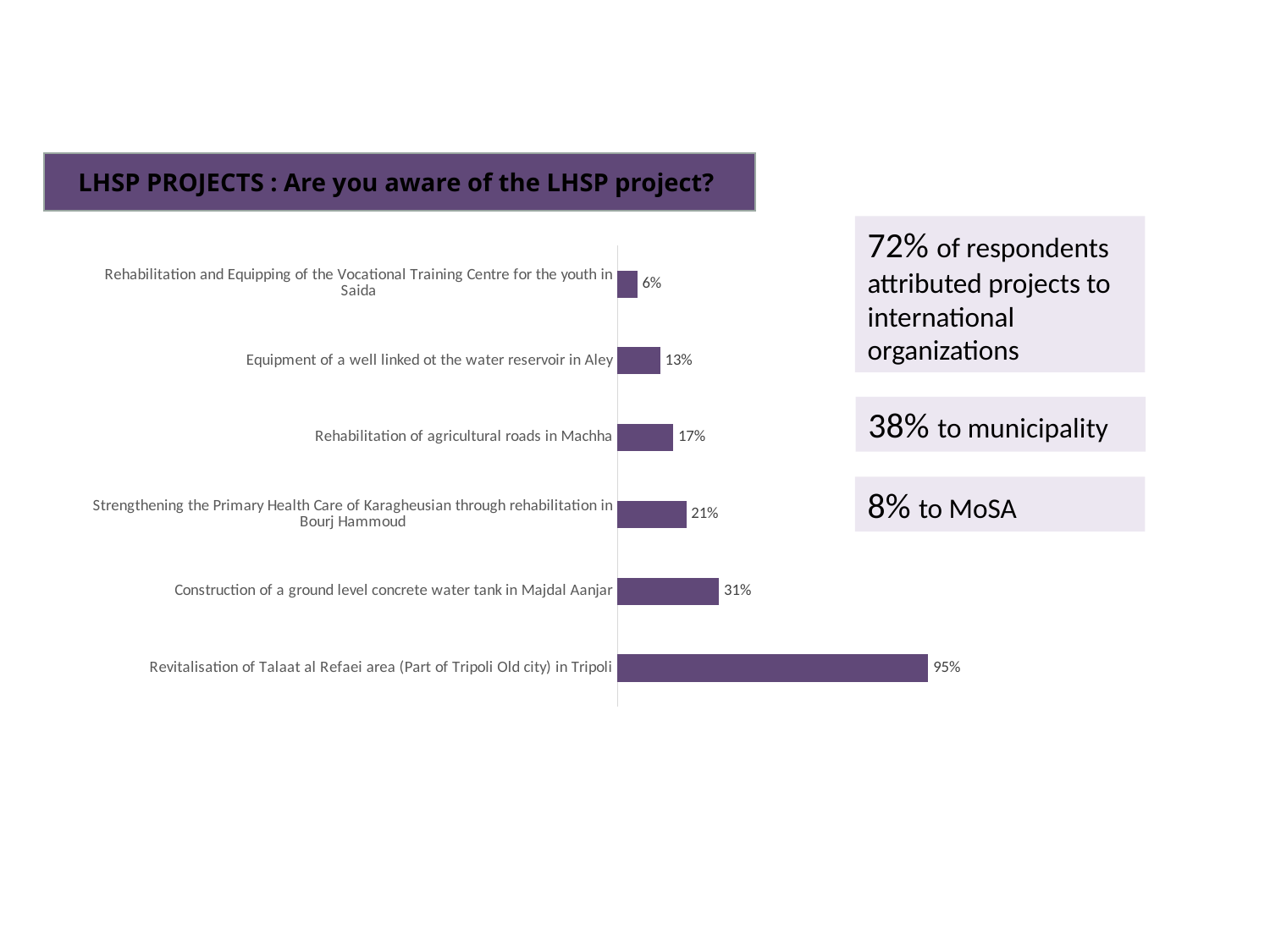
What kind of chart is shown on the slide? Bar chart Which has a larger value: the Rehabilitation of agricultural roads in Machha or the Equipment of a well linked ot the water reservoir in Aley? Rehabilitation of agricultural roads in Machha What is the title of the chart? LHSP PROJECTS : Are you aware of the LHSP project? Which project has the lowest awareness value in the chart? Rehabilitation and Equipping of the Vocational Training Centre for the youth in Saida How many projects are shown in the chart? 6 What percentage of respondents were aware of the Revitalisation of Talaat al Refaei area (Part of Tripoli Old city) in Tripoli project? 95% What is the value shown for the Construction of a ground level concrete water tank in Majdal Aanjar? 31% What is the difference between the values for the Bourj Hammoud project and the Aley project? 8% What is the value shown for the Equipment of a well linked ot the water reservoir in Aley? 13% What is the value shown for the Rehabilitation of agricultural roads in Machha? 17% Which project has the highest awareness value in the chart? Revitalisation of Talaat al Refaei area (Part of Tripoli Old city) in Tripoli What is the difference between the values for the Tripoli project and the Majdal Aanjar project? 64%